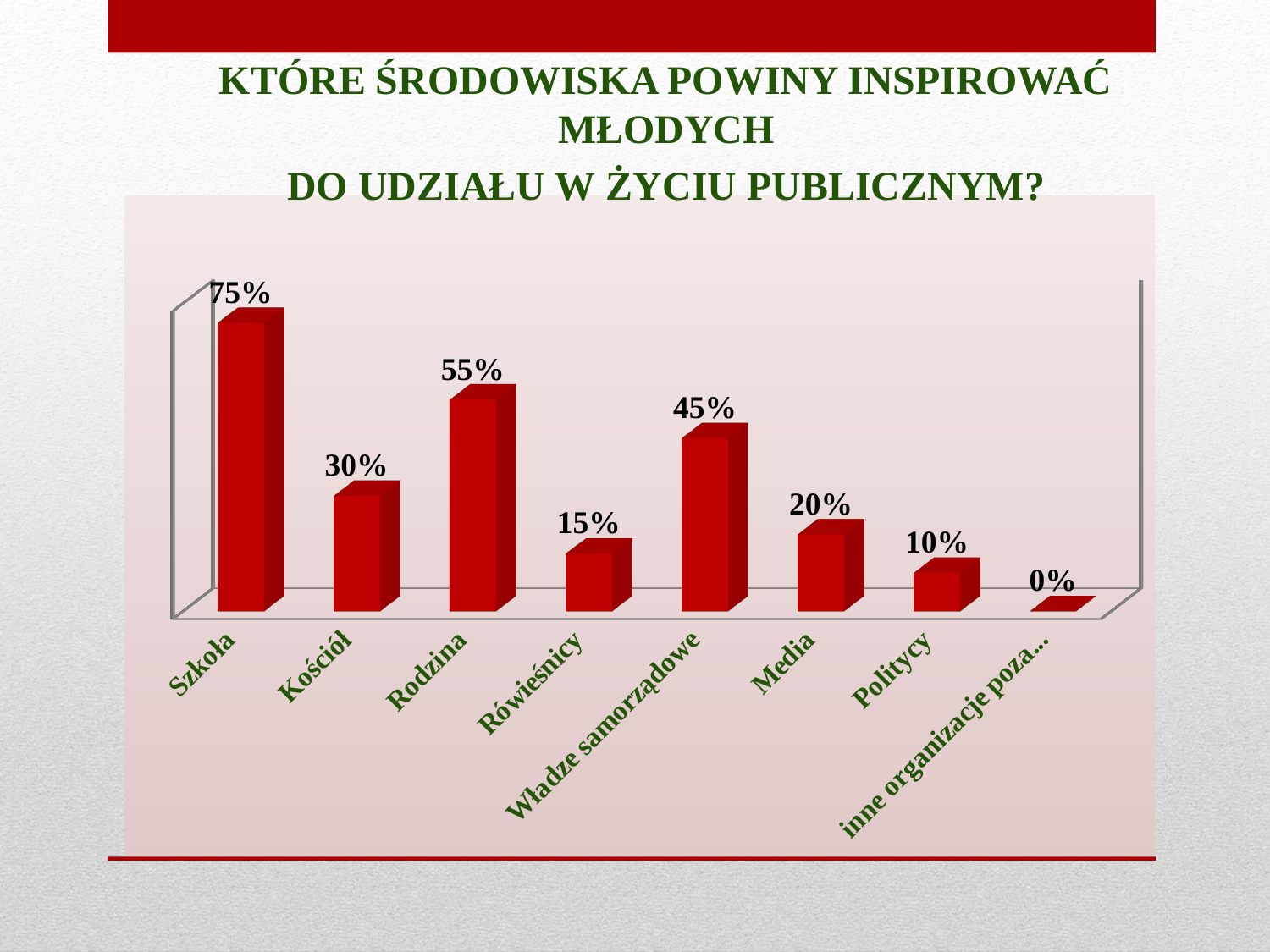
What is the difference between the values for Szkoła and Media? 55% How many categories are shown on the chart? 8 Which is larger, the value for Rówieśnicy or the value for Media? Media What kind of chart is shown on the slide? bar chart What is the value for Szkoła? 75% What is the value for Władze samorządowe? 45% What is the difference between the values for Rodzina and Kościół? 25% Which category has the highest value? Szkoła What is the value for Politycy? 10% Which category has the lowest value? inne organizacje poza... Which is larger, the value for Kościół or the value for Władze samorządowe? Władze samorządowe What colour are the bars in the chart? red